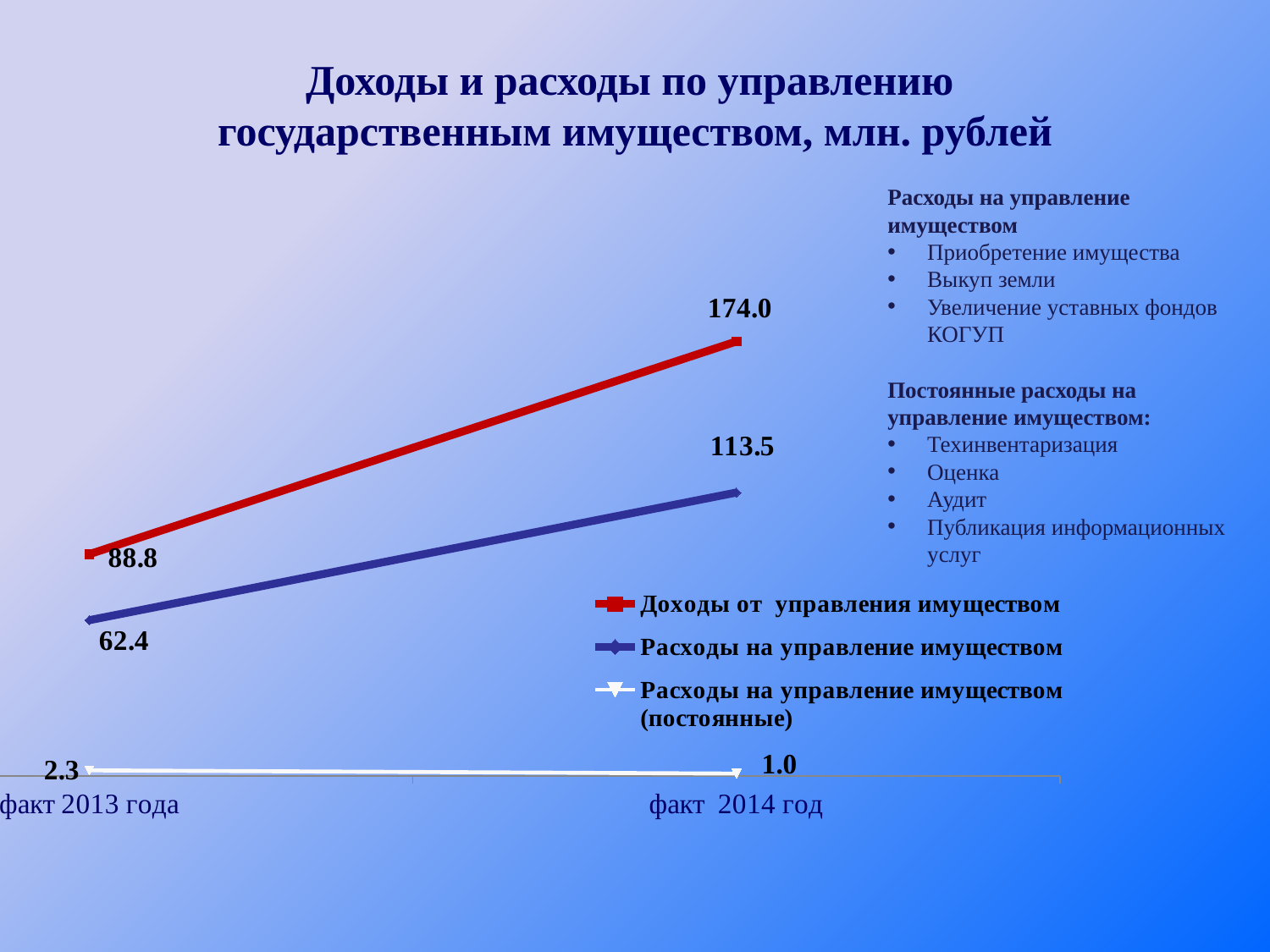
What is the value of Доходы от управления имуществом for факт 2013 года? 88.8 What is the value of Доходы от управления имуществом for факт 2014 год? 174.0 Which series has the lowest value for факт 2013 года? Расходы на управление имуществом (постоянные) By how much did Доходы от управления имуществом increase from факт 2013 года to факт 2014 год? 85.2 Does the value of Расходы на управление имуществом (постоянные) rise or fall from факт 2013 года to факт 2014 год? fall How many points are plotted along the x axis for each series? 2 Which series has the highest value for факт 2014 год? Доходы от управления имуществом What is the value of Расходы на управление имуществом (постоянные) for факт 2014 год? 1.0 What is the value of Расходы на управление имуществом for факт 2013 года? 62.4 What is the difference between Доходы от управления имуществом and Расходы на управление имуществом for факт 2014 год? 60.5 How many series does the legend list? 3 What type of chart is shown on the slide? line chart